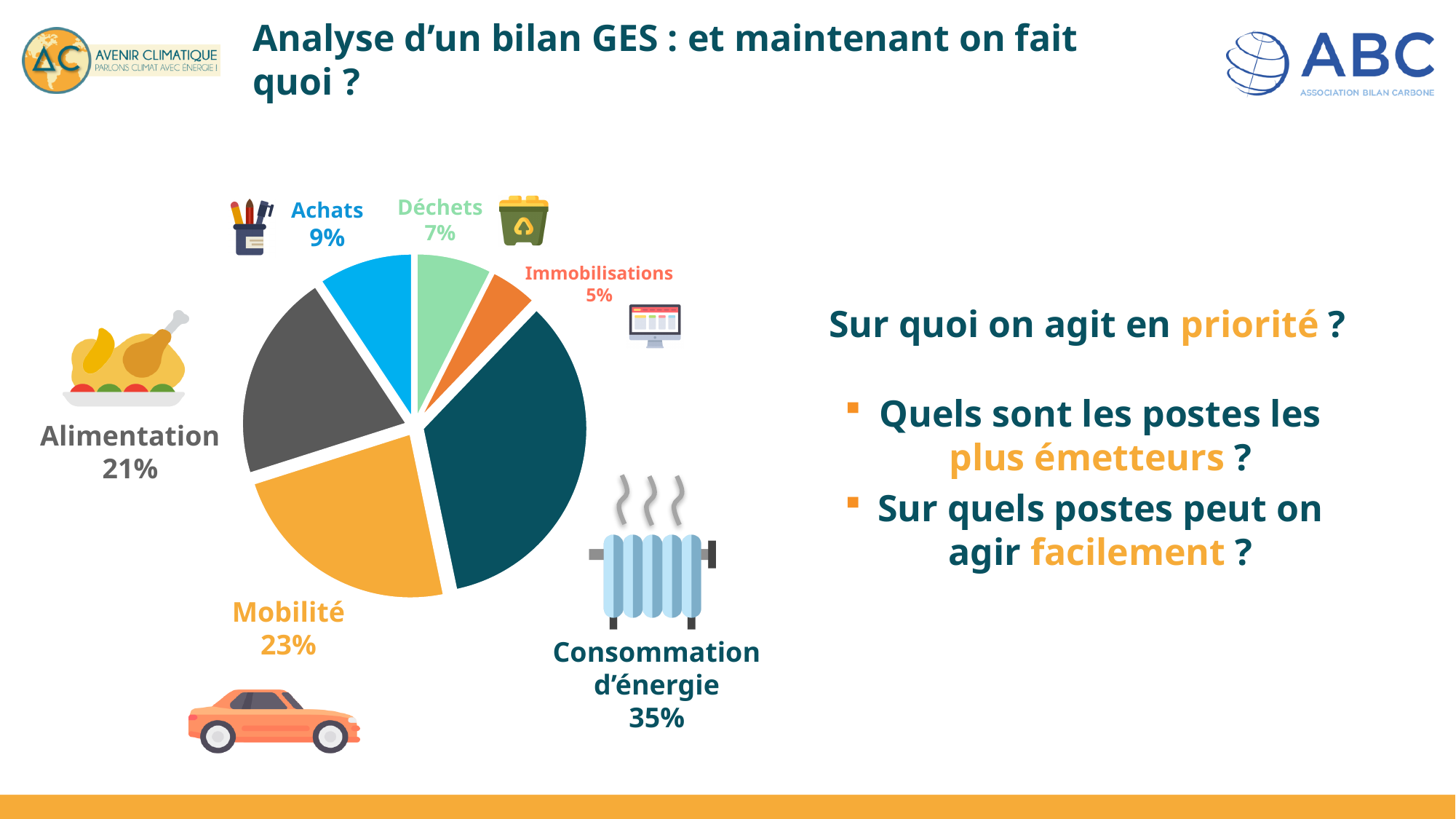
Which category has the largest slice of the pie? Consommation d'énergie What percentage is shown for Alimentation? 21% How many categories are shown in the pie chart? 6 Which category has the smallest slice of the pie? Immobilisations What share of the pie does Consommation d'énergie represent? 35% What is the difference in percentage points between Achats and Déchets? 2 What is the difference in percentage points between Consommation d'énergie and Mobilité? 12 Which is larger, Mobilité or Alimentation? Mobilité What is the value for Immobilisations? 5% What colour is the Achats slice? Blue What is the value shown for Mobilité? 23% What kind of chart is shown on the slide? Pie chart